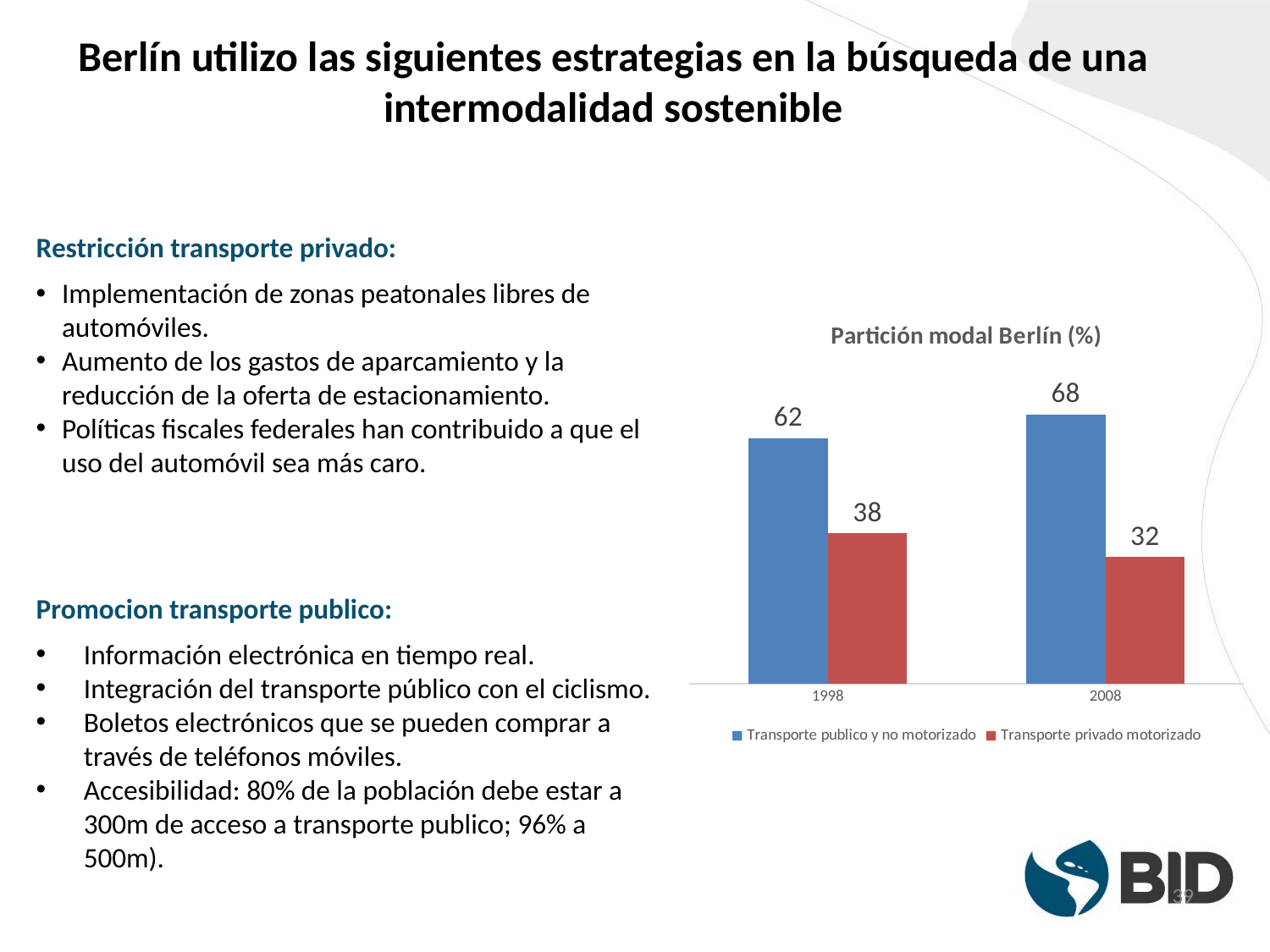
What is the value for Transporte publico y no motorizado in 2008? 68 How many years are shown on the x axis of the chart? 2 Which year has the highest value for Transporte publico y no motorizado? 2008 What is the difference between Transporte publico y no motorizado and Transporte privado motorizado in 2008? 36 What is the value for Transporte privado motorizado in 2008? 32 Which is larger in 1998: Transporte publico y no motorizado or Transporte privado motorizado? Transporte publico y no motorizado How many series does the chart legend list? 2 Which year has the lowest value for Transporte privado motorizado? 2008 What is the value for Transporte publico y no motorizado in 1998? 62 What is the value for Transporte privado motorizado in 1998? 38 What kind of chart is shown on the slide? Bar chart What is the title of the chart? Partición modal Berlín (%)